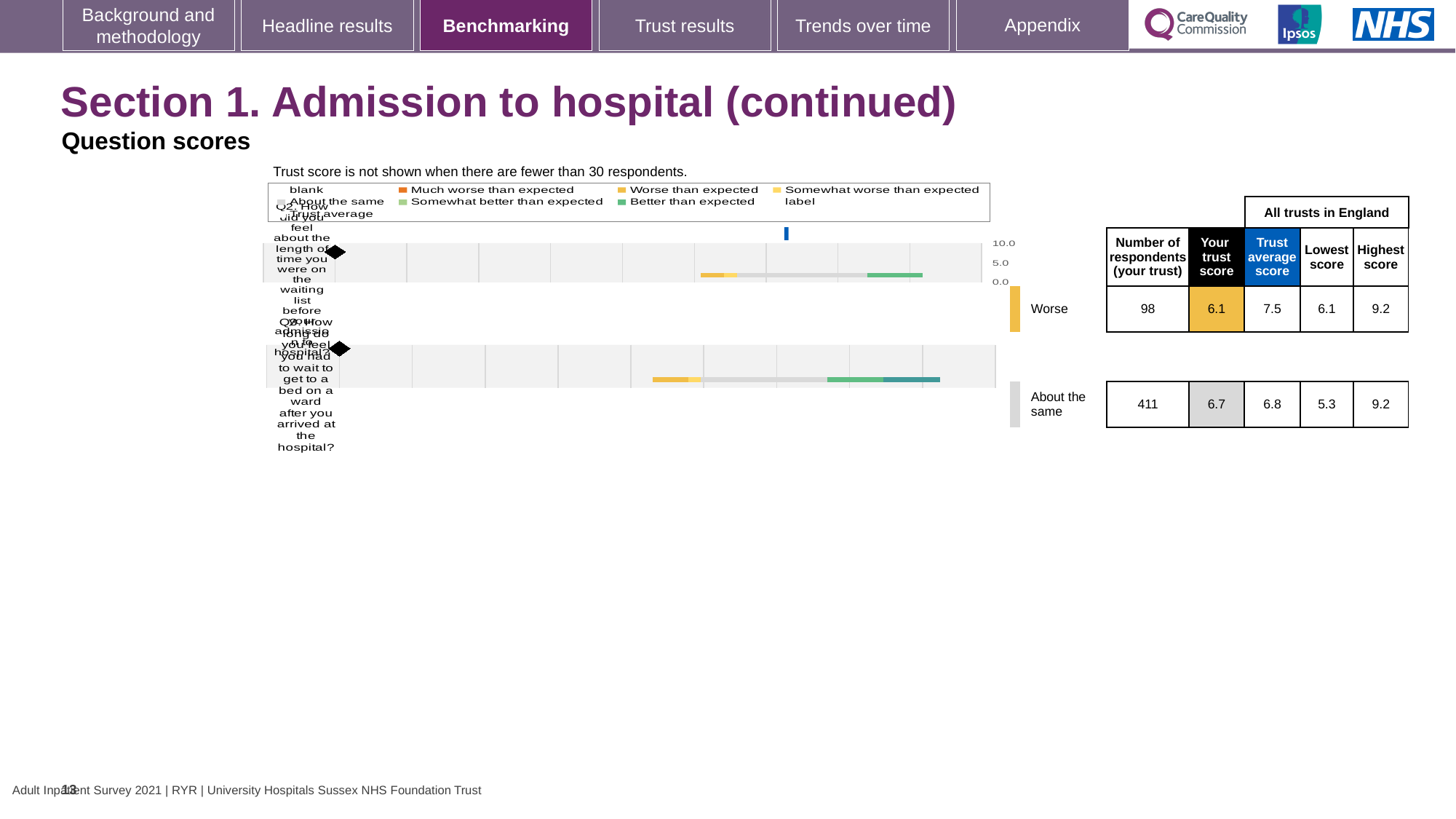
What benchmark category is the trust's Q3 result placed in? About the same What benchmark category is the trust's Q2 result placed in? Worse How many survey questions are plotted in the chart? 2 How many respondents answered Q3 at this trust? 411 What is the lowest score across all trusts in England for Q3? 5.3 What is the trust average score for all trusts in England for Q2? 7.5 What kind of chart is shown on the slide? bar chart What is the trust score for Q2 (length of time on the waiting list before admission)? 6.1 Is the trust score for Q2 greater or less than 5.0 on the axis? greater Which question has the higher trust score, Q2 or Q3? Q3 What is the trust score for Q3 (wait to get to a bed on a ward after arriving at the hospital)? 6.7 What is the difference between the trust scores for Q3 and Q2? 0.6